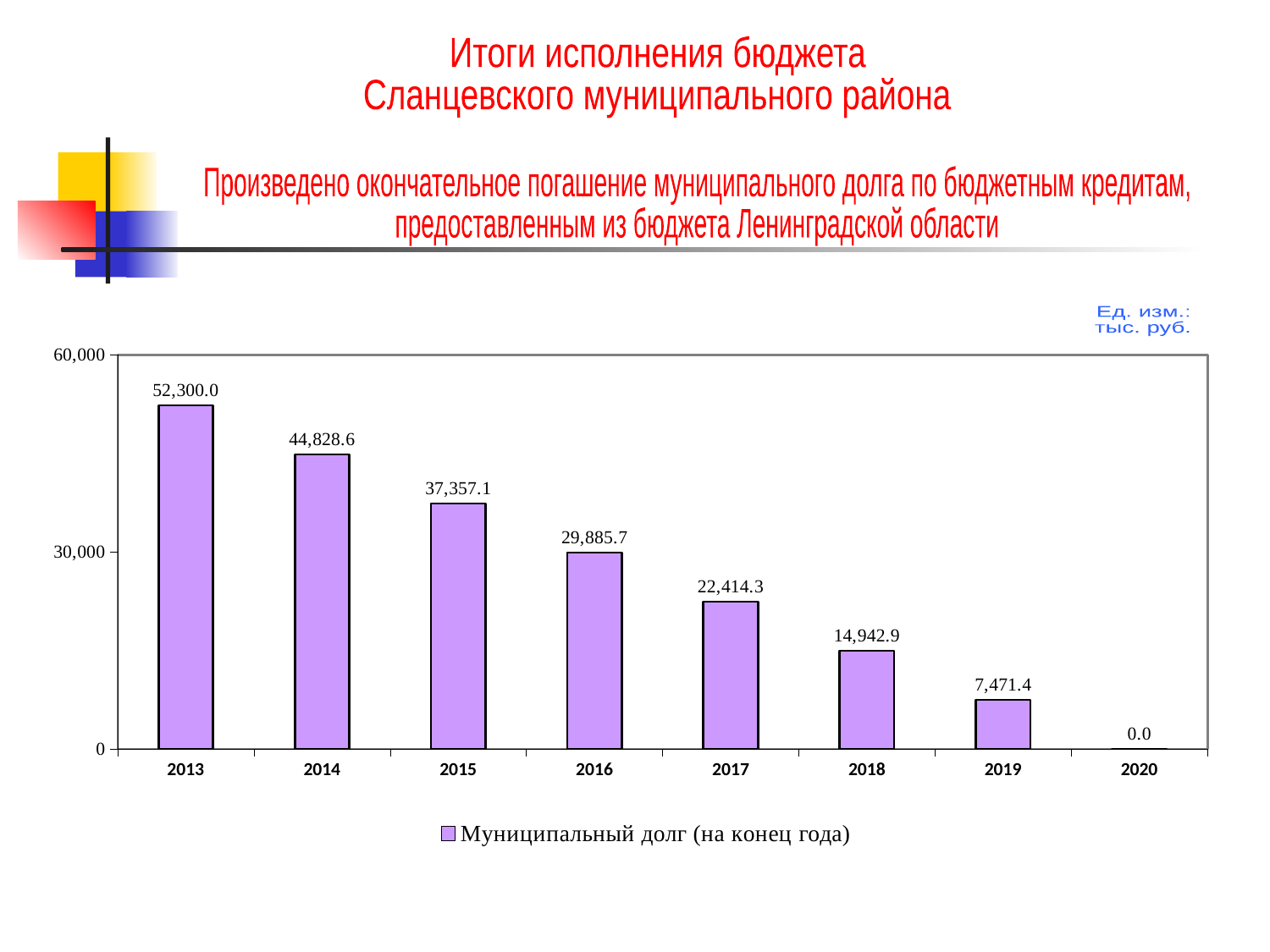
What is the difference between the municipal debt in 2016 and in 2018? 14,942.8 What is the value of municipal debt at the end of 2013? 52,300.0 Which is larger, the municipal debt in 2015 or in 2016? 2015 Which year has the lowest municipal debt? 2020 How many years are shown on the x axis? 8 What is the value of municipal debt at the end of 2017? 22,414.3 What is the difference between the municipal debt in 2013 and in 2014? 7,471.4 Which year has the highest municipal debt? 2013 What is the value of municipal debt at the end of 2020? 0.0 Is the value for 2015 greater or less than 30,000? greater What kind of chart is shown on the slide? bar chart Do the values rise or fall from 2013 to 2020? fall